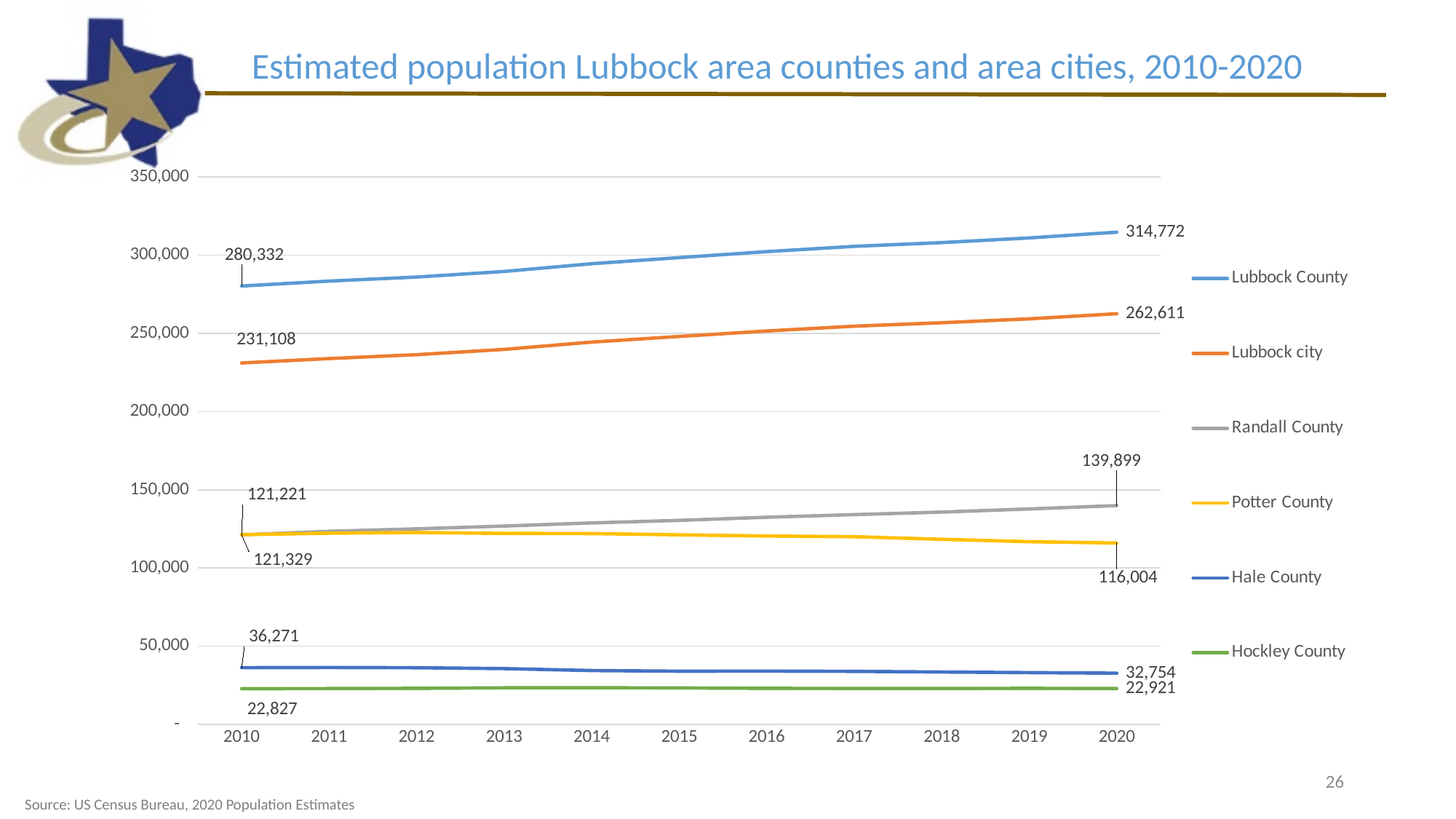
What was the estimated population of Lubbock city in 2010? 231,108 What was the estimated population of Randall County in 2020? 139,899 How many series does the legend list? 6 Does the Hale County population rise or fall from 2010 to 2020? Fall What kind of chart is shown on the slide? Line chart By how much did the Hale County population decrease from 2010 to 2020? 3,517 By how much did the Lubbock County population increase from 2010 to 2020? 34,440 What was the estimated population of Potter County in 2020? 116,004 Which series has the highest population in 2020? Lubbock County Which series has the lowest population in 2020? Hockley County Is the value for Lubbock city in 2013 greater or less than 250,000? less What was the estimated population of Lubbock County in 2020? 314,772